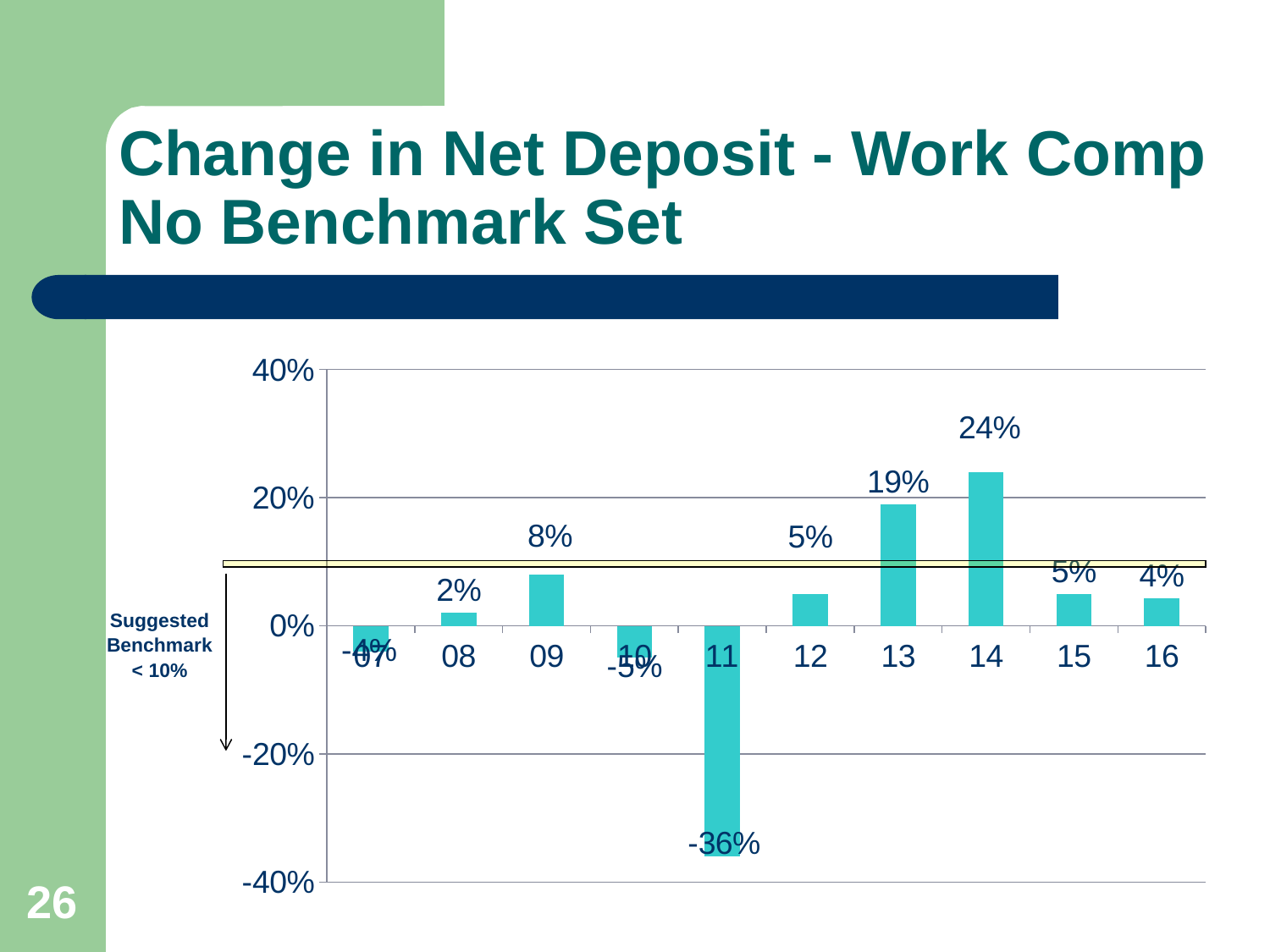
What is the value for 08? 2% How many years are shown on the x axis? 10 What is the value for 13? 19% Which year has the highest value? 14 What is the value for 14? 24% What kind of chart is shown? bar chart What is the value for 09? 8% Which is larger, the value for 12 or the value for 16? 12 What is the value for 11? -36% Which year has the lowest value? 11 Is the value for 11 greater or less than -20%? less What is the difference between the values for 14 and 13? 5%